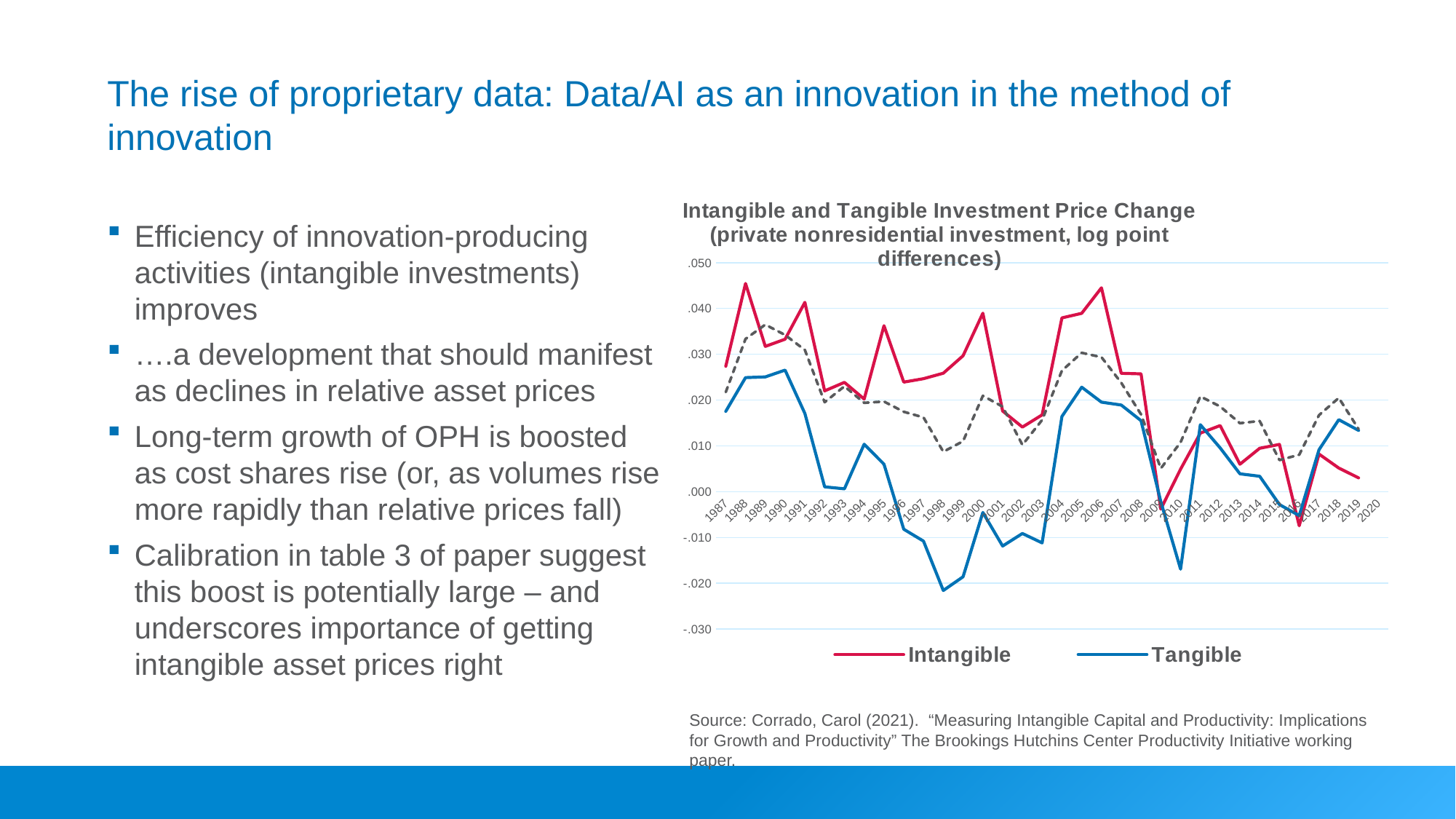
In 1995, which series has the higher value, Intangible or Tangible? Intangible How many years are shown along the x axis of the chart? 34 Is the Tangible value for 1998 greater or less than -.010? less In which year does the Tangible series reach its lowest value? 1998 What is the title of the chart? Intangible and Tangible Investment Price Change (private nonresidential investment, log point differences) Does the Tangible series rise or fall between 1990 and 1998? fall How many series does the chart legend list? 2 Which series is shown in red in the chart? Intangible Is the Intangible value for 1988 greater or less than .040? greater Is the Tangible value for 1990 greater or less than .020? greater What type of chart is shown on the slide? line chart